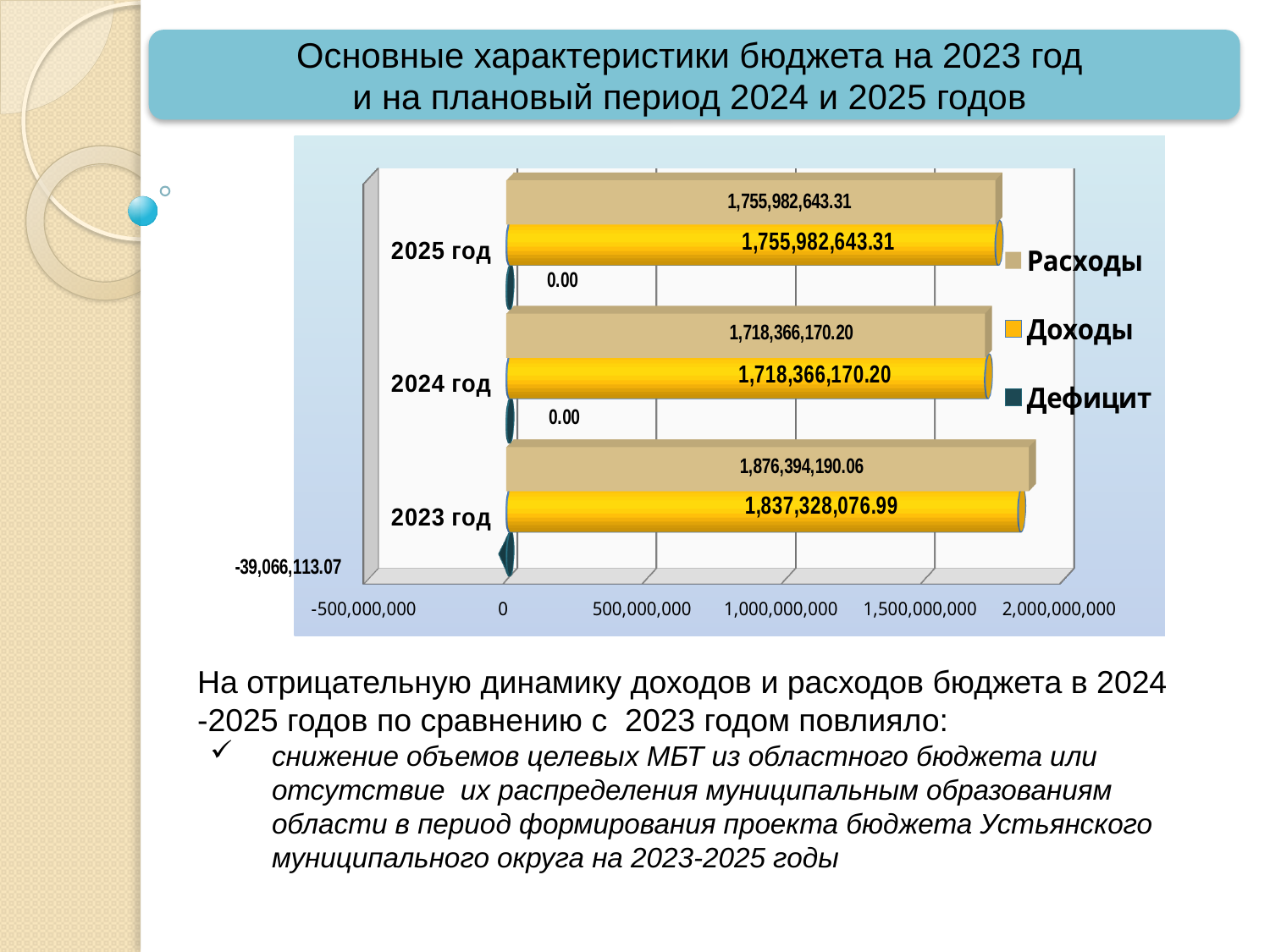
Is the value of Расходы for 2023 год greater or less than 1,500,000,000? greater Which is larger: Доходы for 2025 год or Доходы for 2024 год? 2025 год What is the value of Расходы for 2023 год? 1,876,394,190.06 What is the difference between Расходы and Доходы for 2023 год? 39,066,113.07 What is the value of Доходы for 2024 год? 1,718,366,170.20 Which year has the lowest value of Доходы? 2024 год What is the value of Дефицит for 2023 год? -39,066,113.07 Which year has the highest value of Расходы? 2023 год What is the value of Доходы for 2025 год? 1,755,982,643.31 How many series does the legend list? 3 How many years (categories) are shown on the chart? 3 What kind of chart is shown on the slide? bar chart